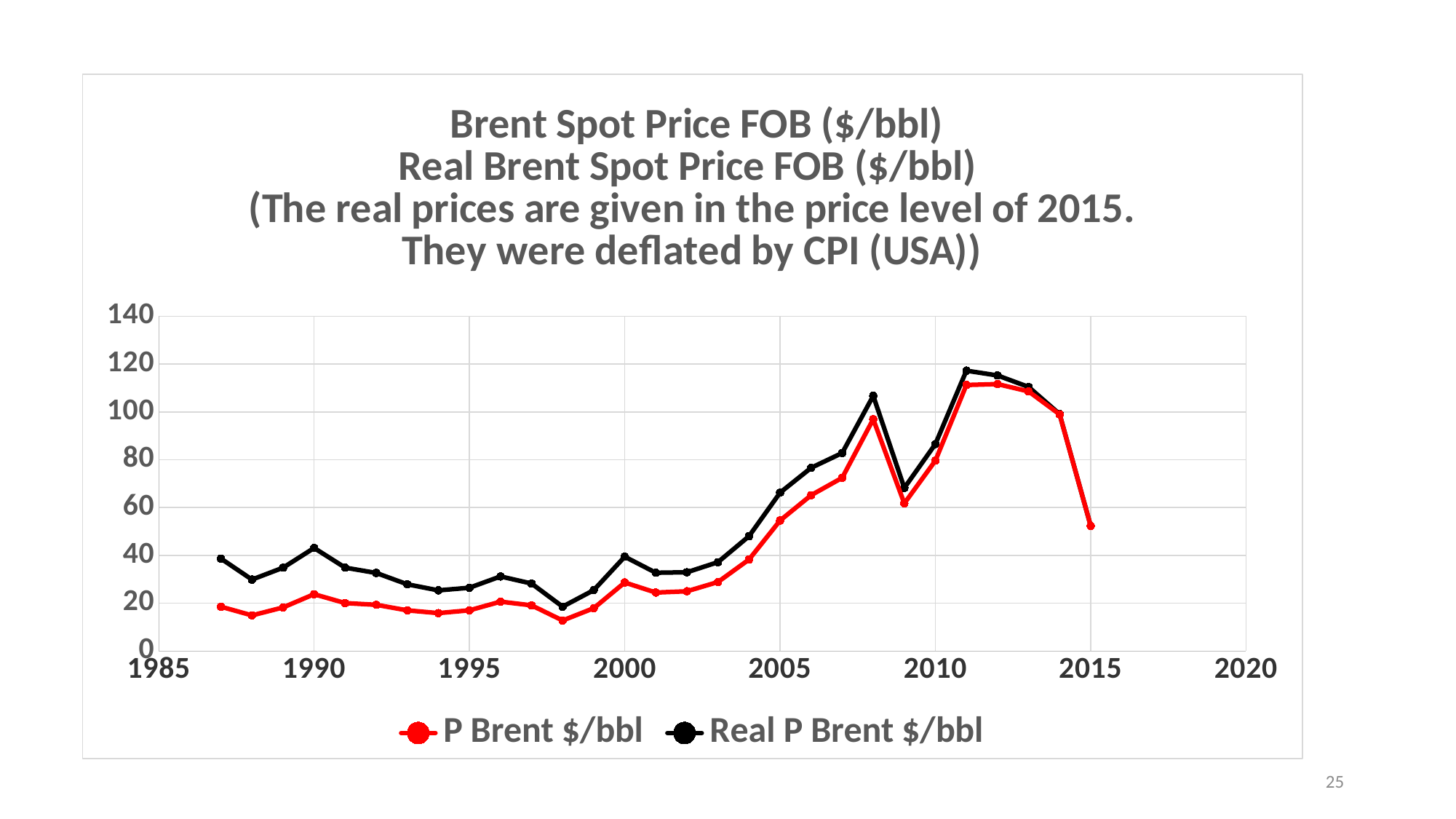
What kind of chart is shown on the slide? line chart In 2000, which series has the higher value: P Brent $/bbl or Real P Brent $/bbl? Real P Brent $/bbl Is the value for P Brent $/bbl in 2009 greater or less than 80? less Is the value for Real P Brent $/bbl in 2008 greater or less than 100? greater Which is larger for P Brent $/bbl: the value in 2008 or the value in 2009? 2008 In which year is the Real P Brent $/bbl series at its lowest? 1998 Is the value for P Brent $/bbl in 2008 greater or less than 80? greater Which series is drawn in red? P Brent $/bbl In which year is the P Brent $/bbl series at its lowest? 1998 Does the P Brent $/bbl series rise or fall from 2012 to 2015? fall How many series does the legend list? 2